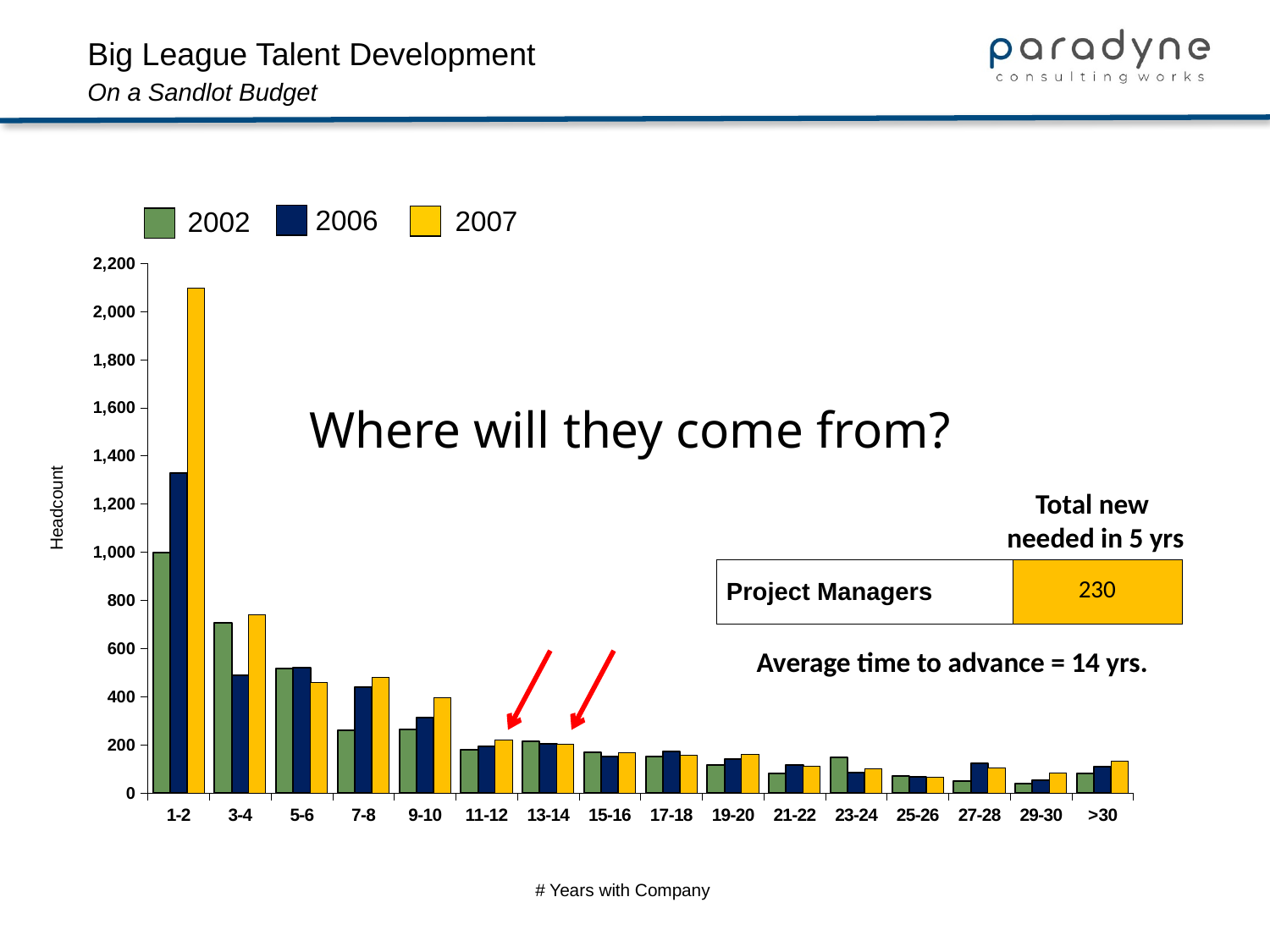
Which year series has the highest bar in the 1-2 years category? 2007 How many categories are shown along the x axis? 16 Is the 2007 value for the 1-2 years category greater or less than 2,000? greater Is the 2006 value for the 1-2 years category greater or less than 1,200? greater What kind of chart is shown on the slide? bar chart What is the label on the x axis of the chart? # Years with Company In the 3-4 years category, which is larger: the 2006 value or the 2007 value? 2007 Is the 2006 value for the 3-4 years category greater or less than 600? less Do the headcount values generally rise or fall as the number of years with the company increases? fall What is the label on the y axis of the chart? Headcount How many series does the legend list? 3